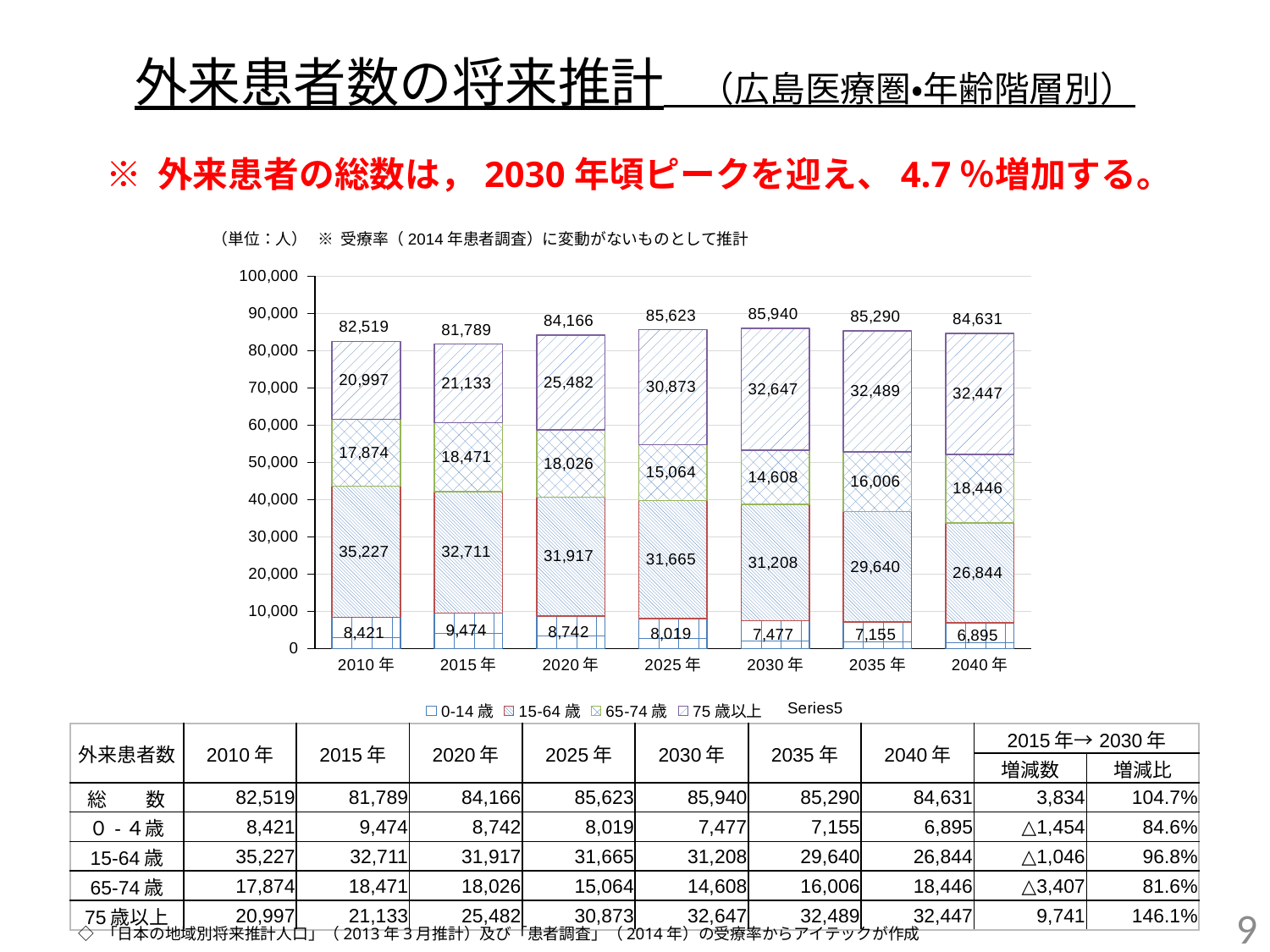
Which is larger, the 65-74歳 value for 2015年 or for 2025年? 2015年 What is the total shown above the stacked bar for 2030年? 85,940 What is the value of the 75歳以上 segment for 2030年? 32,647 Which year has the lowest total outpatient count? 2015年 Does the 15-64歳 segment rise or fall from 2010年 to 2040年? fall What type of chart is shown on the slide? stacked bar chart What is the value of the 0-14歳 segment for 2040年? 6,895 How many years (categories) are plotted on the x axis of the chart? 7 Which year has the highest total outpatient count? 2030年 How many series does the chart legend list? 5 What is the difference between the 75歳以上 values for 2040年 and 2010年? 11,450 What is the value of the 15-64歳 segment for 2010年? 35,227